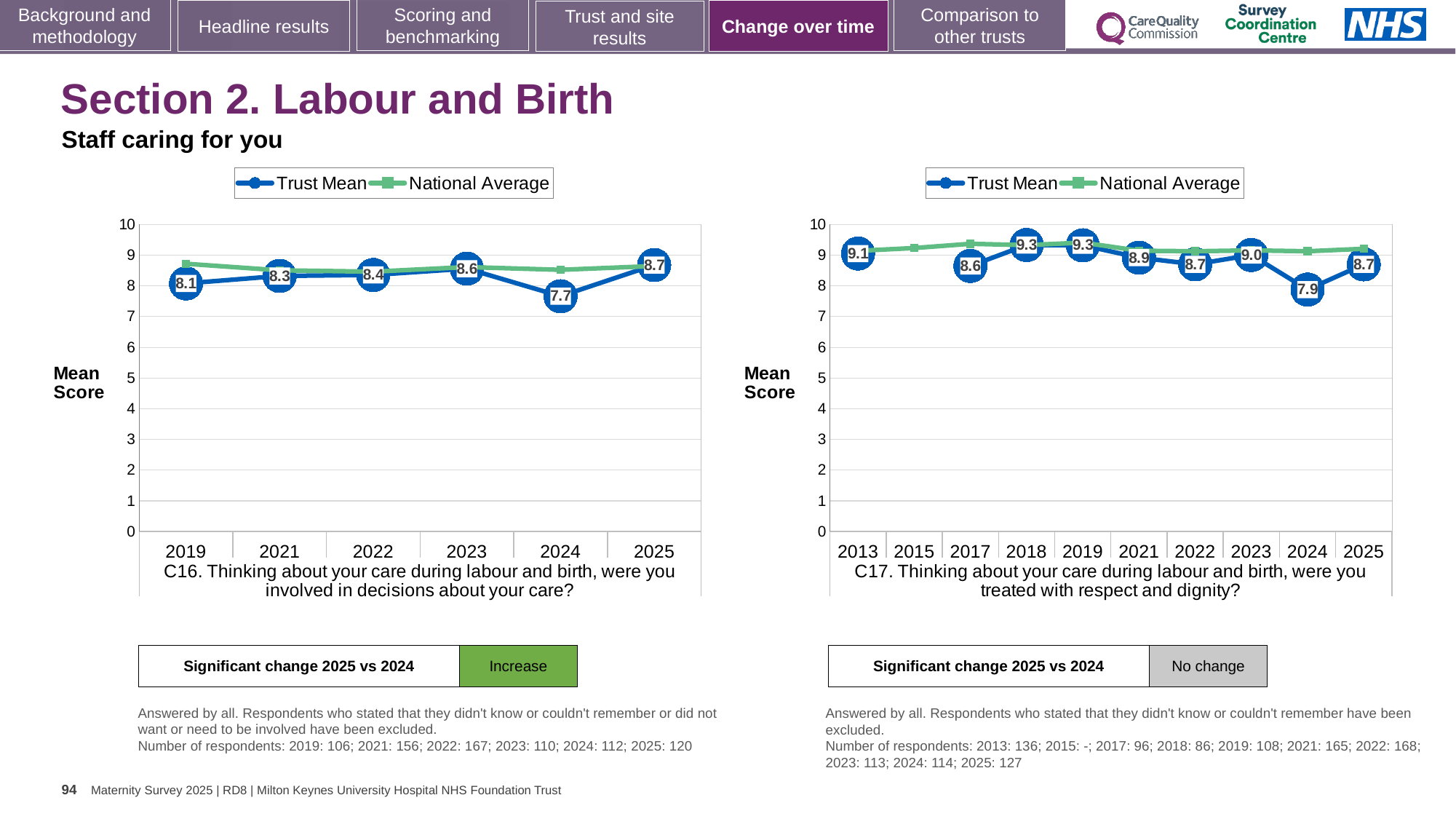
What type of chart is the C16 chart on the left? Line chart How many series does the legend of the C17 chart on the right list? 2 In the C17 chart on the right, which year has the lowest Trust Mean? 2024 In the C17 chart on the right, what is the Trust Mean for 2024? 7.9 In the C17 chart on the right, is the Trust Mean for 2018 larger or smaller than the Trust Mean for 2017? larger In the C17 chart on the right, what is the Trust Mean for 2013? 9.1 In the C16 chart on the left, what is the difference between the Trust Mean for 2025 and 2024? 1.0 In the C16 chart on the left, which year has the lowest Trust Mean? 2024 In the C16 chart on the left, what is the Trust Mean for 2024? 7.7 In the C16 chart on the left, how many years are plotted on the x axis? 6 In the C16 chart on the left, what is the Trust Mean for 2025? 8.7 In the C16 chart on the left, is the National Average for 2024 greater or less than 8? greater